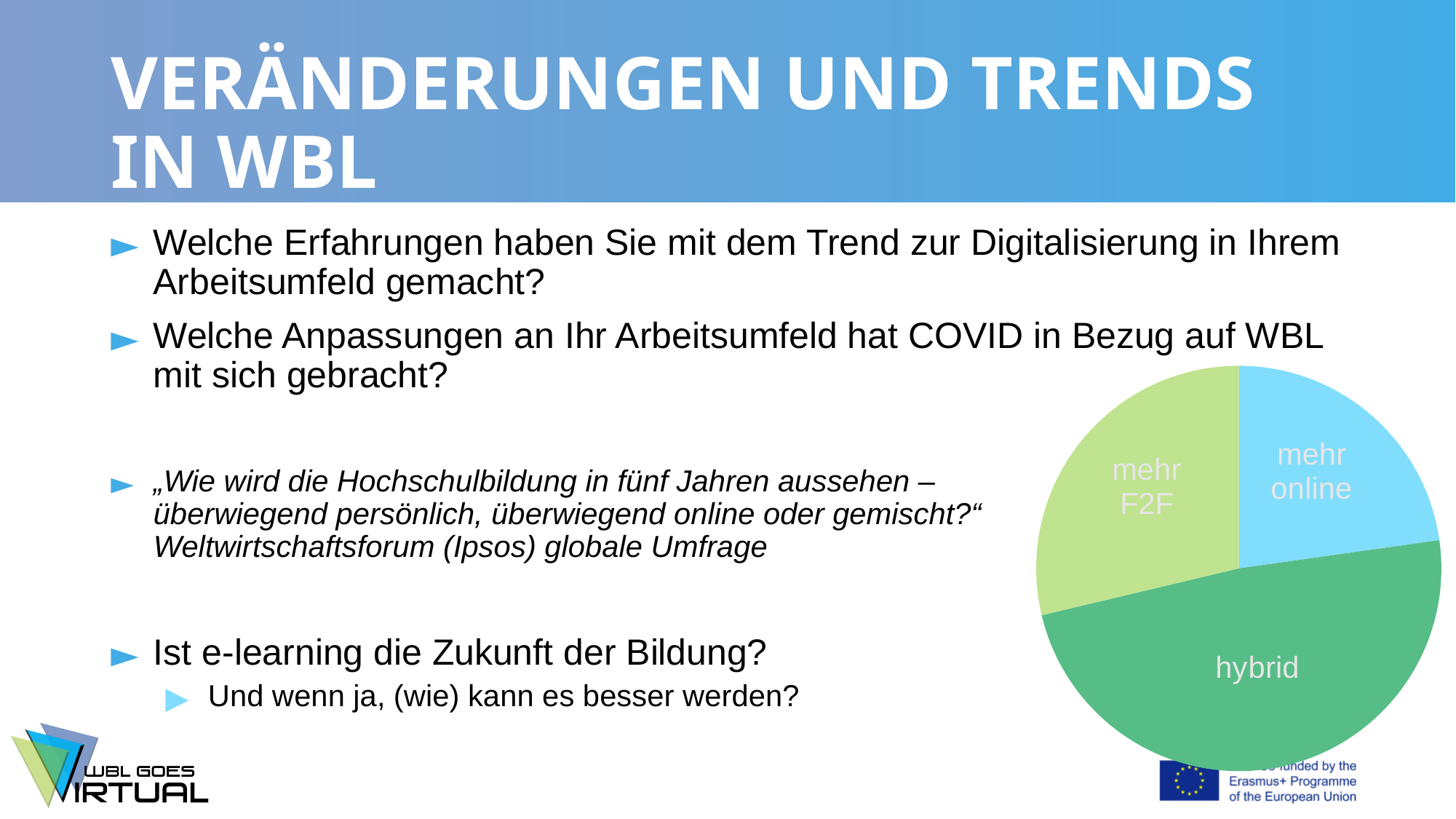
Which slice of the pie chart is coloured light blue? mehr online How many slices does the pie chart have? 3 In the pie chart, which slice is larger: hybrid or mehr online? hybrid What colour is the hybrid slice of the pie chart? green In the pie chart, which slice is larger: mehr F2F or mehr online? mehr F2F Which slice of the pie chart is the largest? hybrid What kind of chart is shown on the slide? pie chart Which slice of the pie chart is the smallest? mehr online In the pie chart, which slice is larger: mehr F2F or hybrid? hybrid